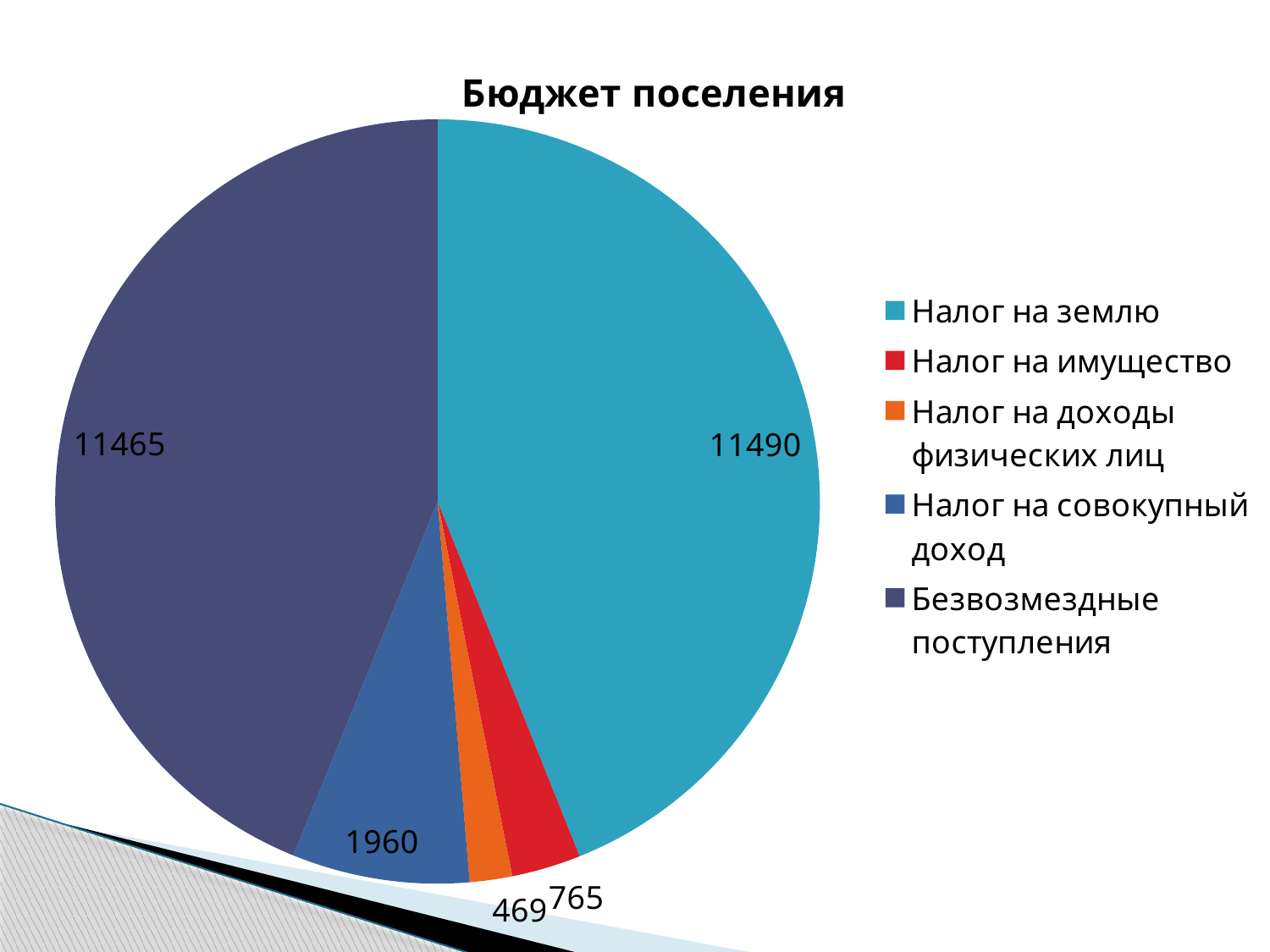
What is the title of the chart? Бюджет поселения What is the value for Безвозмездные поступления? 11465 What is the value for Налог на землю? 11490 What kind of chart is shown on the slide? pie chart What is the value for Налог на совокупный доход? 1960 What is the total of all slices in the pie chart? 26149 Which is larger, Налог на имущество or Налог на доходы физических лиц? Налог на имущество How many categories does the pie chart have? 5 What is the difference between Налог на совокупный доход and Налог на имущество? 1195 What is the value for Налог на доходы физических лиц? 469 Which category has the largest value according to the data labels? Налог на землю Which category has the smallest slice? Налог на доходы физических лиц